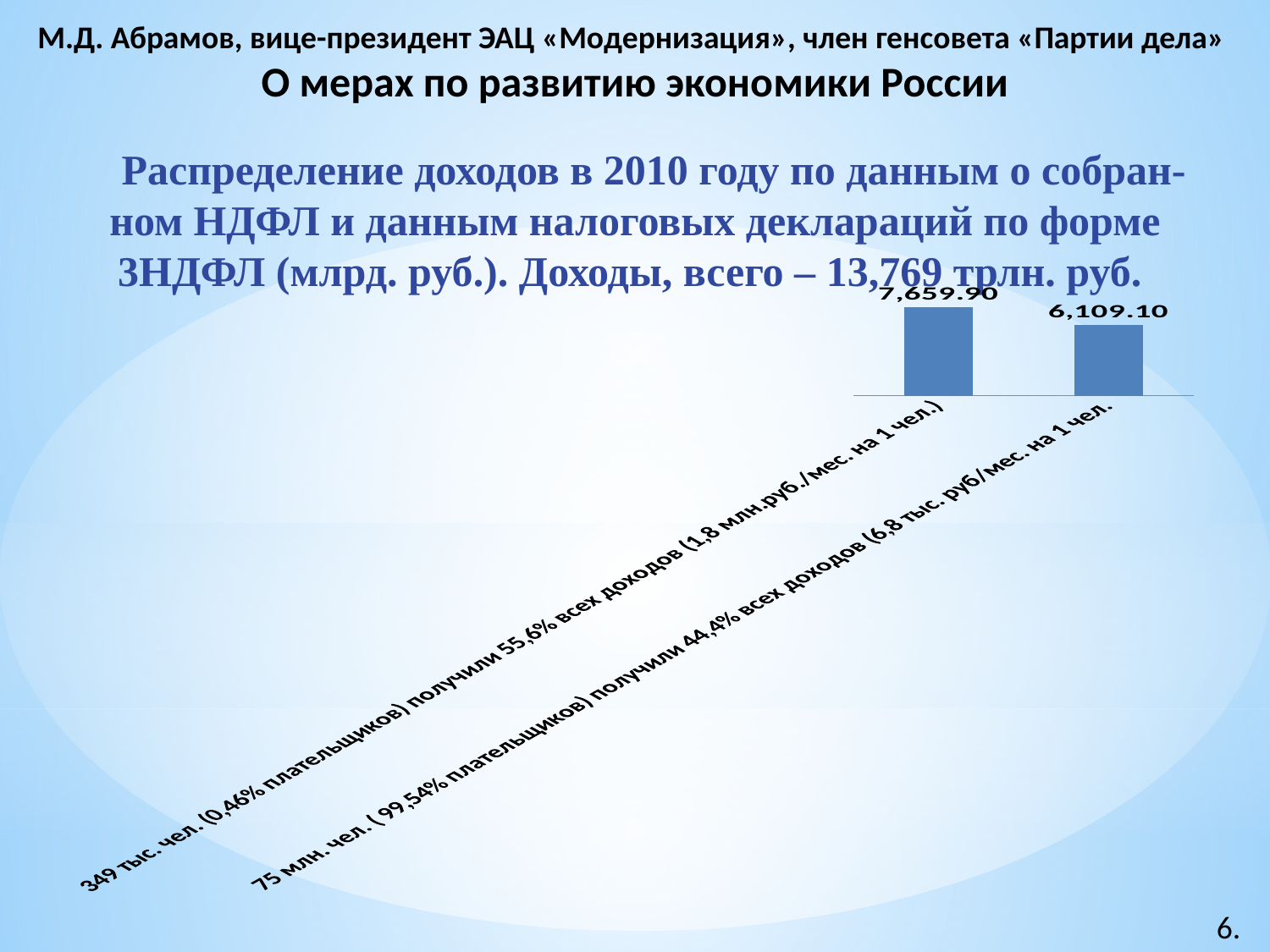
According to the heading above the chart, what is the total income (Доходы, всего)? 13,769 трлн. руб. What colour are the bars in the chart? blue Do the bar values rise or fall from left to right along the x axis? fall Which category has the highest value in the chart? 349 тыс. чел. (0,46% плательщиков) получили 55,6% всех доходов (1,8 млн.руб./мес. на 1 чел.) What kind of chart is shown on the slide? bar chart What is the value of the bar for "75 млн. чел. (99,54% плательщиков) получили 44,4% всех доходов"? 6,109.10 Which is larger: the value for the 349 тыс. чел. category or the value for the 75 млн. чел. category? 349 тыс. чел. category What is the difference between the value for the 349 тыс. чел. category and the value for the 75 млн. чел. category? 1,550.80 What is the sum of the two bar values in the chart? 13,769.00 Which category has the lowest value in the chart? 75 млн. чел. (99,54% плательщиков) получили 44,4% всех доходов (6,8 тыс. руб/мес. на 1 чел. What is the value of the bar for "349 тыс. чел. (0,46% плательщиков) получили 55,6% всех доходов"? 7,659.90 How many bars does the chart have? 2